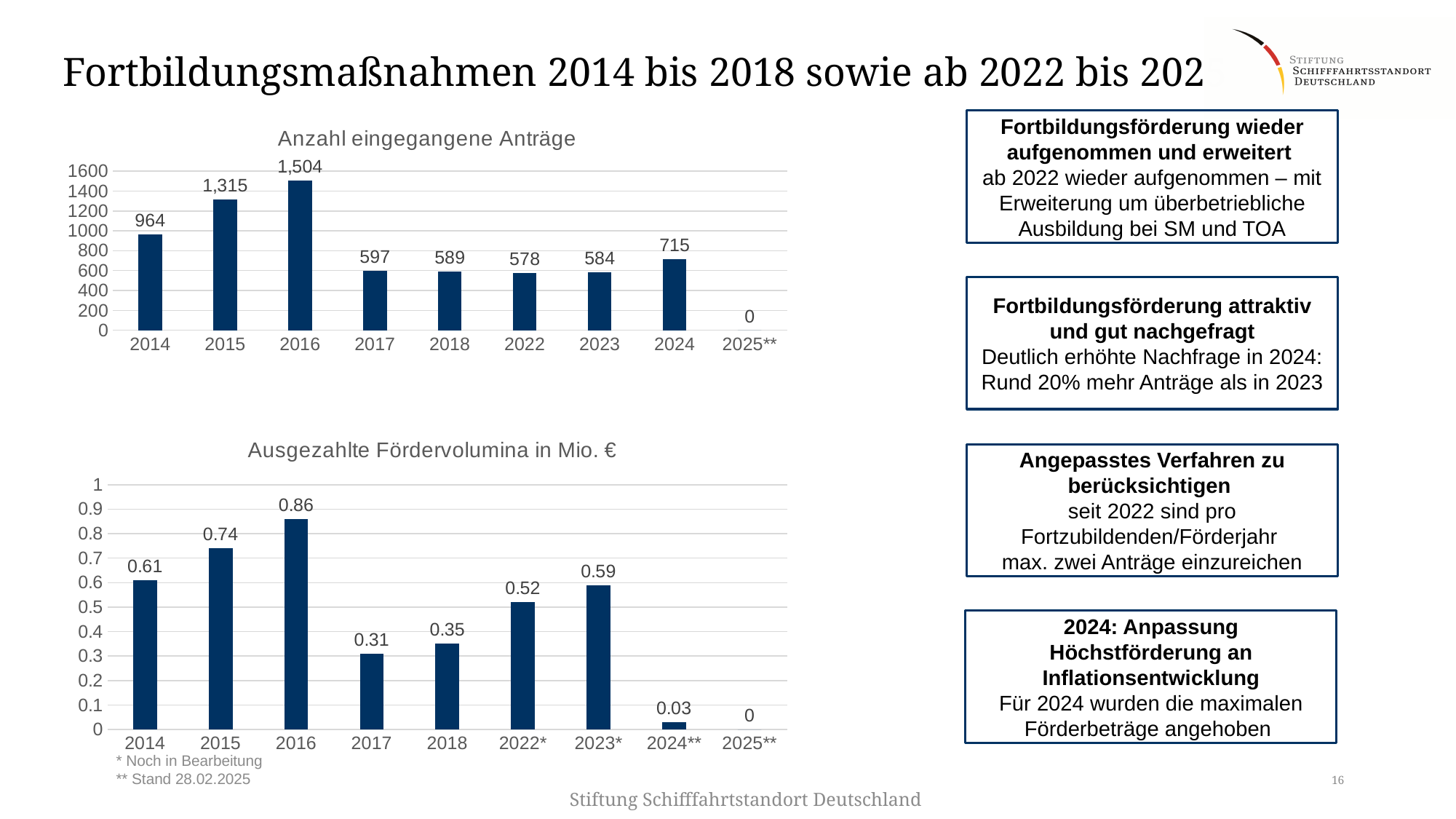
What type of chart is the lower chart 'Ausgezahlte Fördervolumina in Mio. €'? bar chart In the chart 'Ausgezahlte Fördervolumina in Mio. €', what is the value for 2023*? 0.59 In the chart 'Ausgezahlte Fördervolumina in Mio. €', what is the difference between the values for 2016 and 2015? 0.12 In the chart 'Ausgezahlte Fördervolumina in Mio. €', which is larger, the value for 2017 or the value for 2018? 2018 In the chart 'Ausgezahlte Fördervolumina in Mio. €', what is the value for 2024**? 0.03 In the chart 'Anzahl eingegangene Anträge', do the values rise or fall from 2014 to 2016? rise In the chart 'Anzahl eingegangene Anträge', how many categories are shown on the x axis? 9 In the chart 'Ausgezahlte Fördervolumina in Mio. €', which year has the highest value? 2016 In the chart 'Anzahl eingegangene Anträge', what is the value for 2016? 1,504 In the chart 'Anzahl eingegangene Anträge', is the value for 2015 greater or less than 1200? greater In the chart 'Anzahl eingegangene Anträge', what is the difference between the values for 2024 and 2023? 131 In the chart 'Anzahl eingegangene Anträge', which year has the highest value? 2016